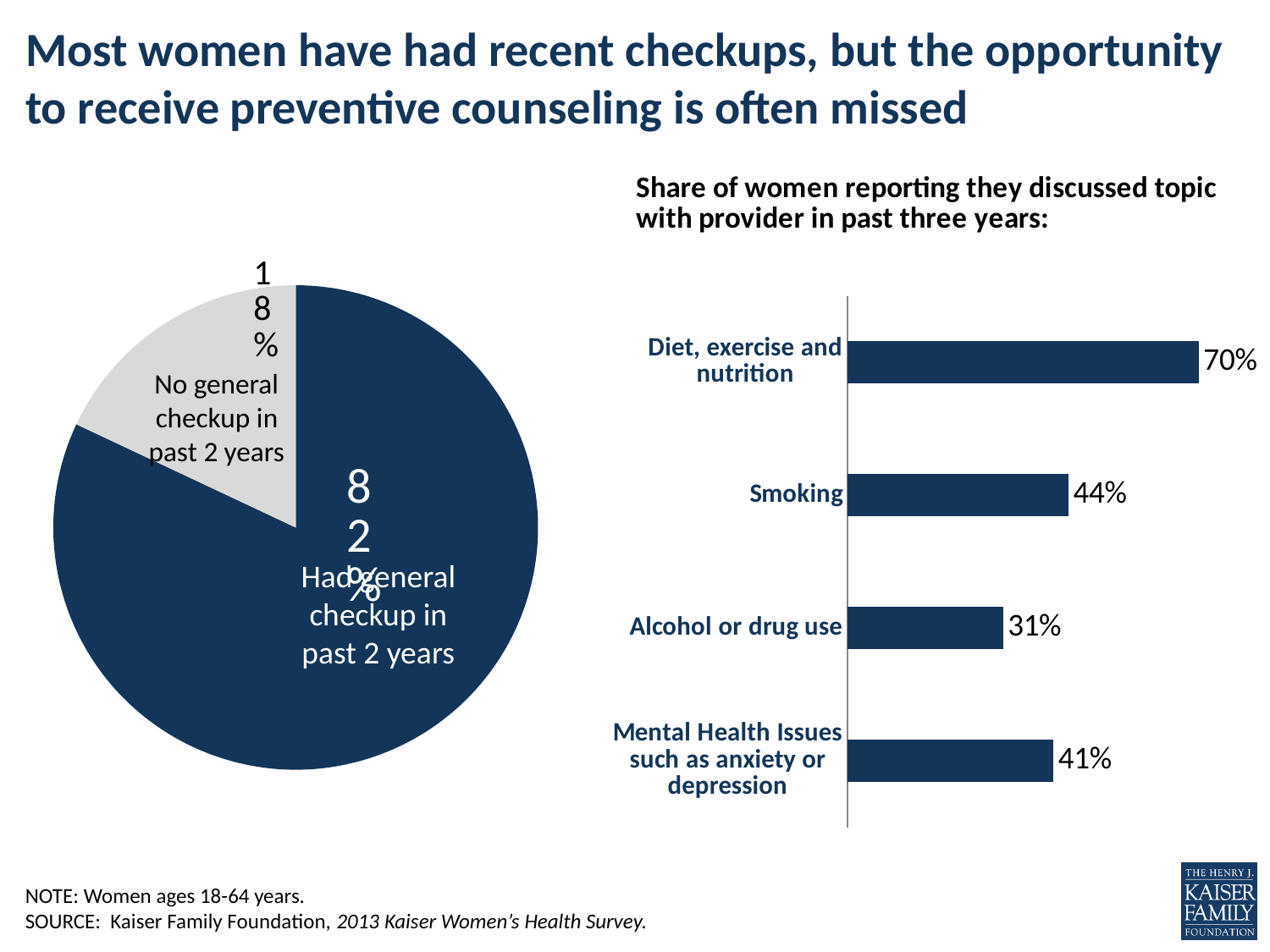
In the bar chart on the right, which is larger: the share for smoking or the share for mental health issues such as anxiety or depression? Smoking In the bar chart on the right, what share of women reported discussing smoking with a provider? 44% What kind of chart is on the right side of the slide? Bar chart In the bar chart on the right, what share of women reported discussing diet, exercise and nutrition with a provider? 70% In the bar chart on the right, what share of women reported discussing alcohol or drug use with a provider? 31% In the bar chart on the right, which topic has the highest share of women reporting they discussed it with a provider? Diet, exercise and nutrition What is the title of the bar chart on the right? Share of women reporting they discussed topic with provider in past three years: In the bar chart on the right, what is the difference between the share for diet, exercise and nutrition and the share for smoking? 26% In the pie chart on the left, what share of women had a general checkup in the past 2 years? 82% How many topics are shown in the bar chart on the right? 4 In the pie chart on the left, what share of women had no general checkup in the past 2 years? 18% In the bar chart on the right, which topic has the lowest share? Alcohol or drug use